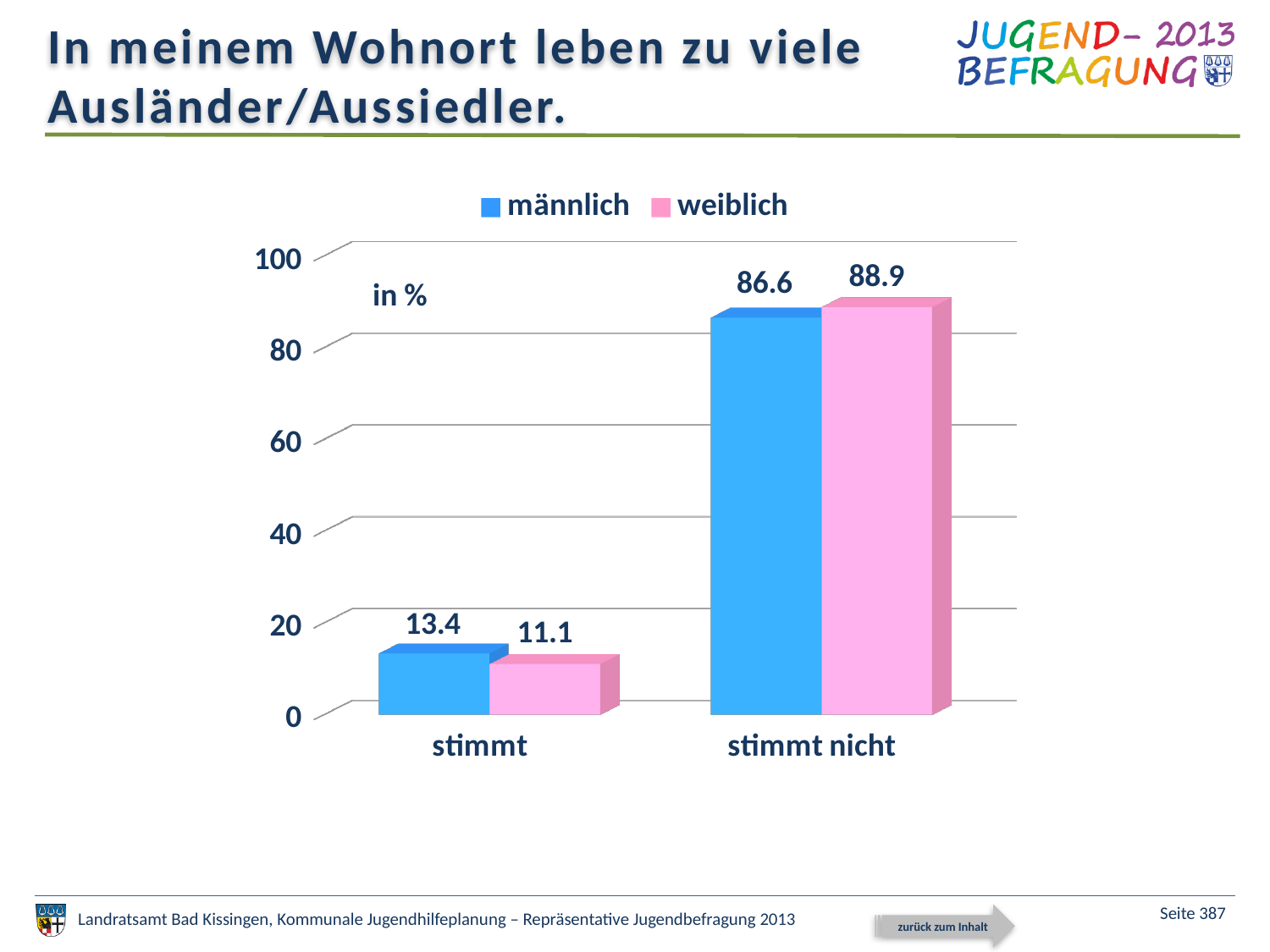
Which category has the highest value for weiblich? stimmt nicht What is the value for männlich in the stimmt category? 13.4 Which category has the lowest value for männlich? stimmt What is the value for weiblich in the stimmt category? 11.1 What is the difference between the weiblich and männlich values in the stimmt nicht category? 2.3 How many categories are shown on the x axis? 2 What is the value for männlich in the stimmt nicht category? 86.6 How many series does the legend list? 2 What is the difference between the männlich and weiblich values in the stimmt category? 2.3 In the stimmt category, which is larger: männlich or weiblich? männlich What kind of chart is shown on the slide? bar chart What is the value for weiblich in the stimmt nicht category? 88.9